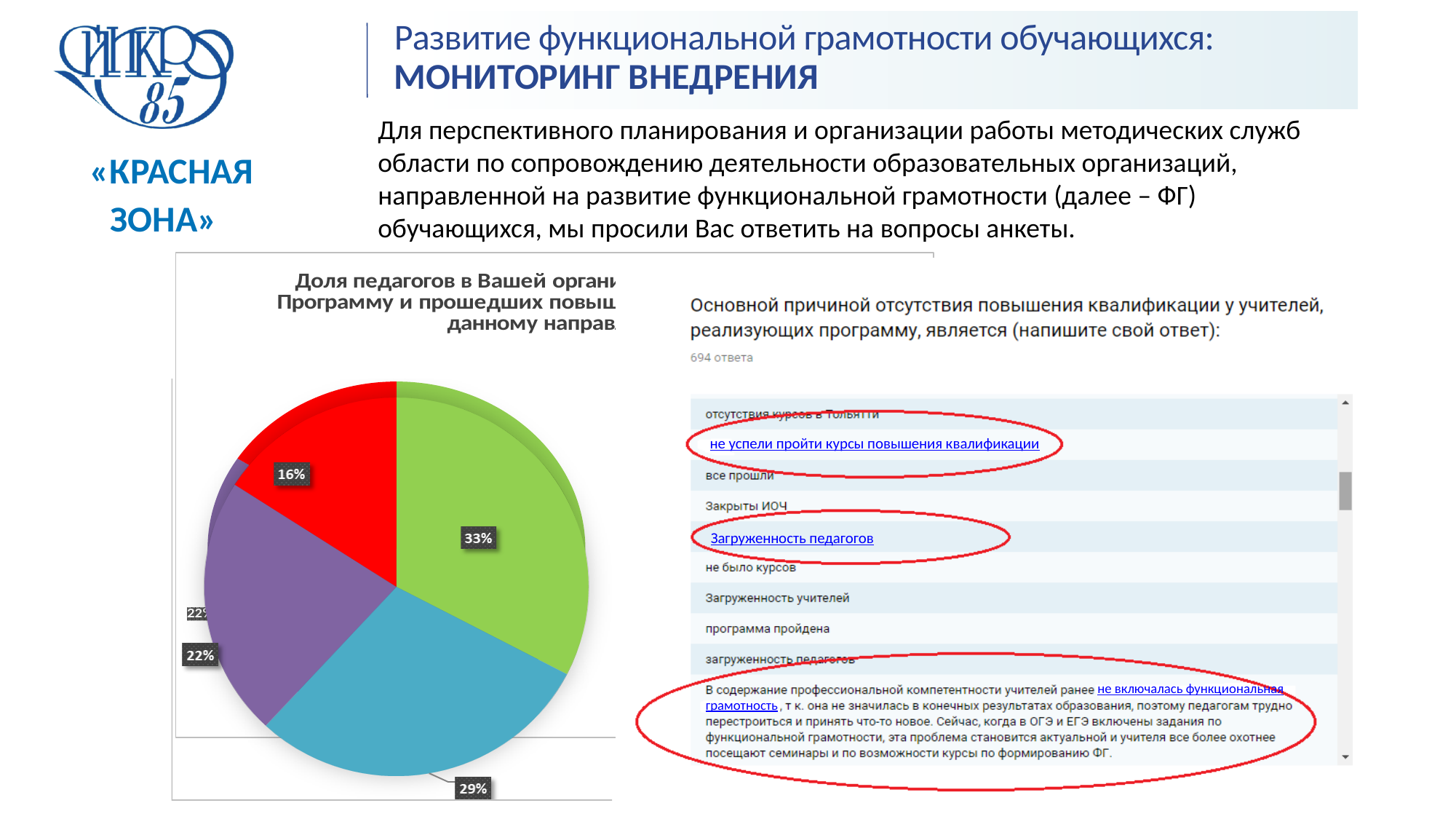
What is the difference in percentage points between the green slice and the red slice of the pie chart? 17 What kind of chart is shown on the left of the slide? pie chart Which colour slice of the pie chart is the smallest? red What percentage is shown on the blue slice of the pie chart? 29% What is the difference in percentage points between the blue slice and the purple slice of the pie chart? 7 What percentage is shown on the red slice of the pie chart? 16% Which is larger in the pie chart, the green slice or the blue slice? green What colour is the slice labelled 29% in the pie chart? blue What percentage is shown on the green slice of the pie chart? 33% Which colour slice of the pie chart is the largest? green How many slices does the pie chart have? 4 What percentage is shown on the purple slice of the pie chart? 22%